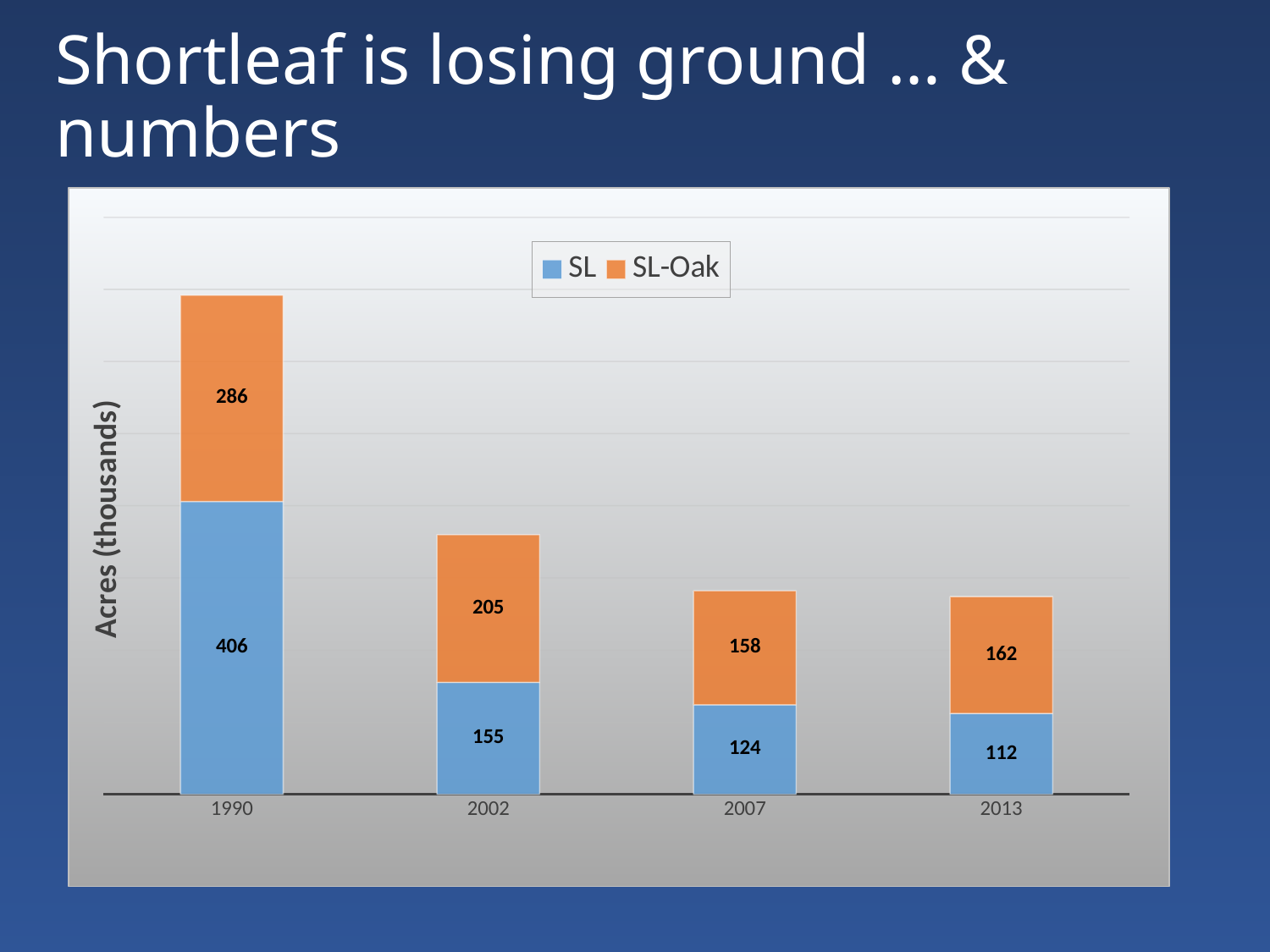
Which year has the lowest SL-Oak value? 2007 What is the SL value for 1990? 406 Which year has the highest SL value? 1990 Which is larger, the SL-Oak value for 2007 or for 2013? 2013 What is the SL-Oak value for 2002? 205 What is the total of the stacked bar for 2013? 274 How many series does the legend list? 2 What is the total of the stacked bar for 1990? 692 What is the difference between the SL values for 1990 and 2002? 251 What kind of chart is shown? Stacked bar chart How many years are shown on the x axis? 4 What is the SL value for 2013? 112